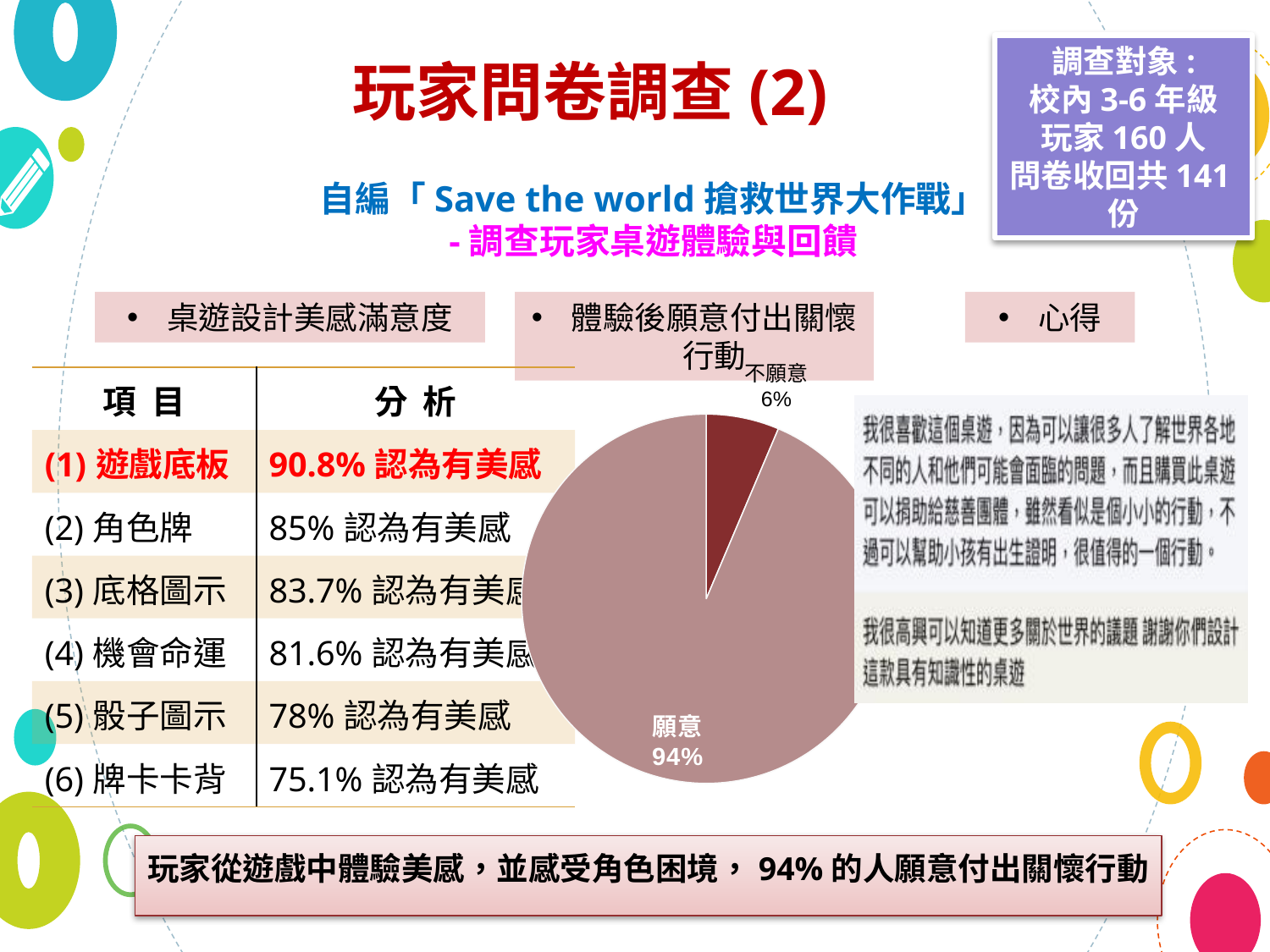
What percentage of the pie chart is labelled 願意? 94% What kind of chart is shown on the slide? pie chart Which is larger in the pie chart, 願意 or 不願意? 願意 Is the value for 願意 in the pie chart greater or less than 50%? greater What percentage of the pie chart is labelled 不願意? 6% Which slice of the pie chart is the smallest? 不願意 What colour is the 不願意 slice of the pie chart? dark red What is the difference in percentage points between the 願意 slice and the 不願意 slice? 88% How many slices does the pie chart have? 2 Which section heading does the pie chart appear under? 體驗後願意付出關懷行動 Which slice of the pie chart is the largest? 願意 What share of the pie does the 願意 slice represent? 94%